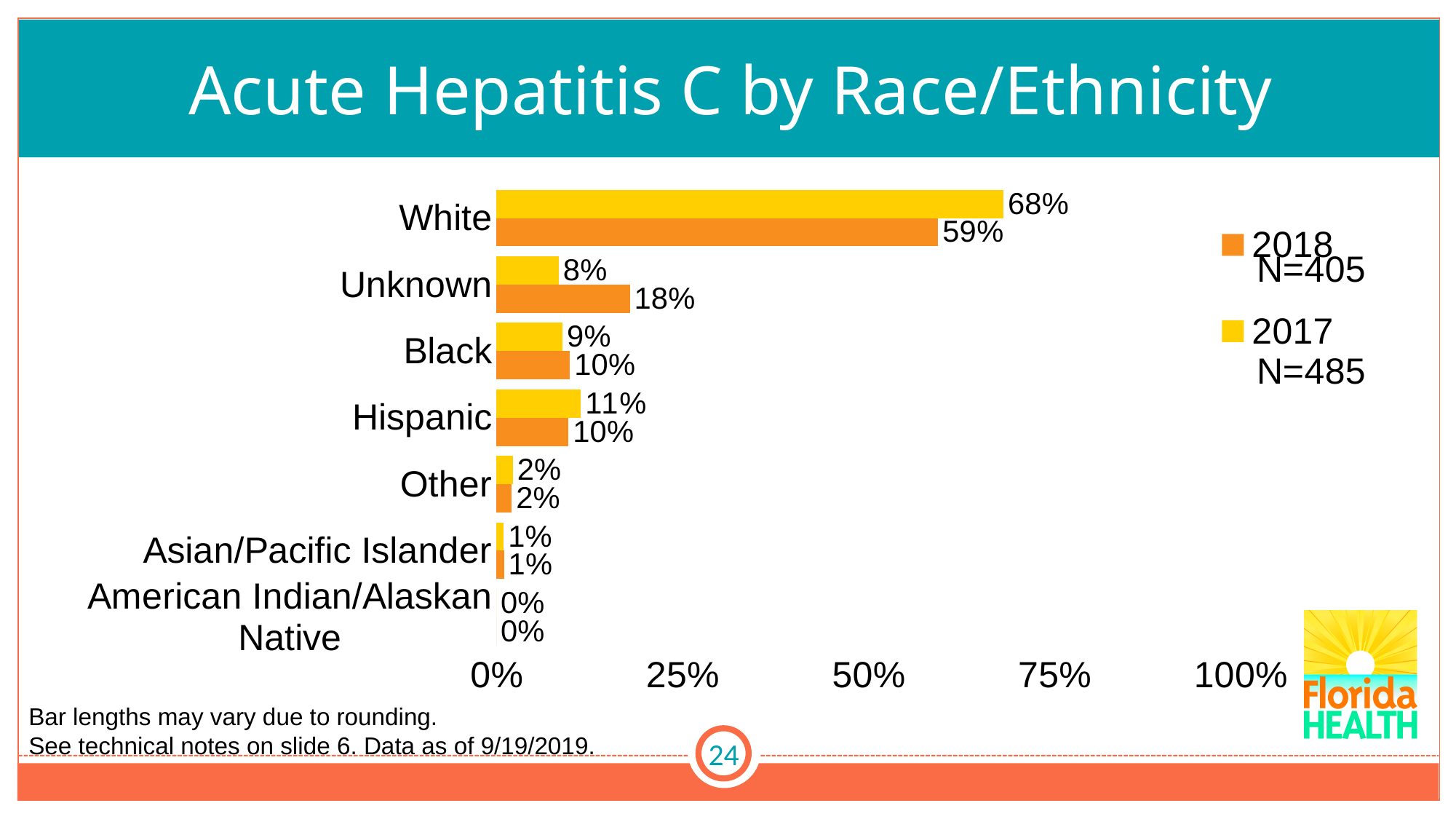
How many race/ethnicity categories are shown on the chart? 7 What is the difference between the 2018 and 2017 values for Unknown? 10% What is the difference between the 2017 and 2018 values for White? 9% Which race/ethnicity category has the highest value in 2018? White Which is larger, the 2017 value for Black or the 2018 value for Black? 2018 Which race/ethnicity category has the lowest value in 2017? American Indian/Alaskan Native What percentage of acute hepatitis C cases were White in 2017? 68% What percentage of acute hepatitis C cases were White in 2018? 59% What is the value for Hispanic in 2017? 11% What type of chart is shown on the slide? bar chart How many series does the legend list? 2 What is the value for Unknown race/ethnicity in 2018? 18%